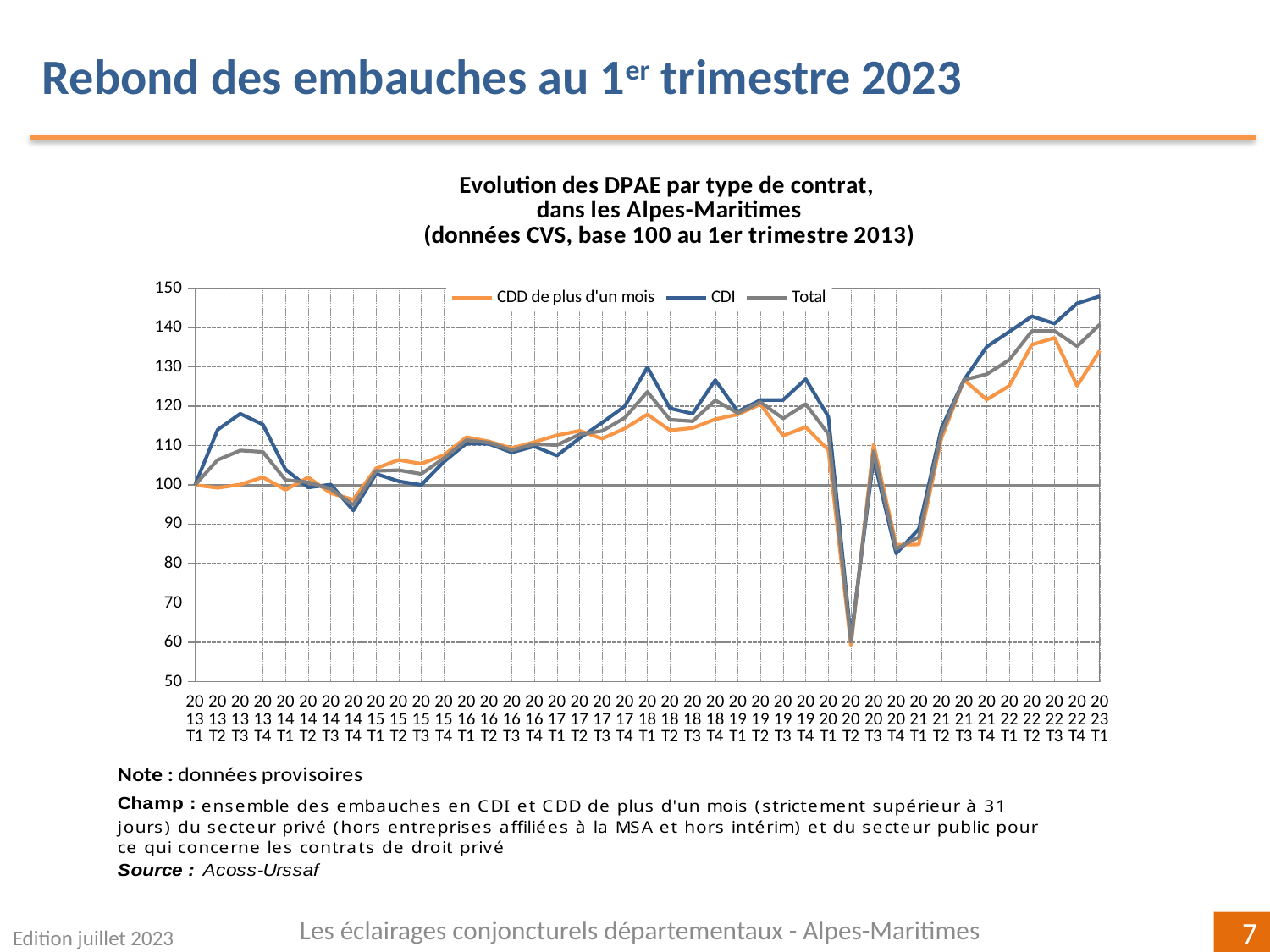
Is the value of the CDI series at 2013 T3 greater or less than 110? greater What is the value of the Total series at 2013 T1, the base quarter? 100 What kind of chart is shown on the slide? Line chart At 2023 T1, which series is higher: CDI or CDD de plus d'un mois? CDI Which colour is used for the CDD de plus d'un mois series? Orange In which quarter does the CDI series reach its lowest value? 2020 T2 Is the value of the CDD de plus d'un mois series at 2020 T2 greater or less than 70? less Is the value of the CDI series at 2023 T1 greater or less than 140? greater In which quarter does the CDI series reach its highest value? 2023 T1 How many series does the legend list? 3 How many quarters are plotted along the x axis? 41